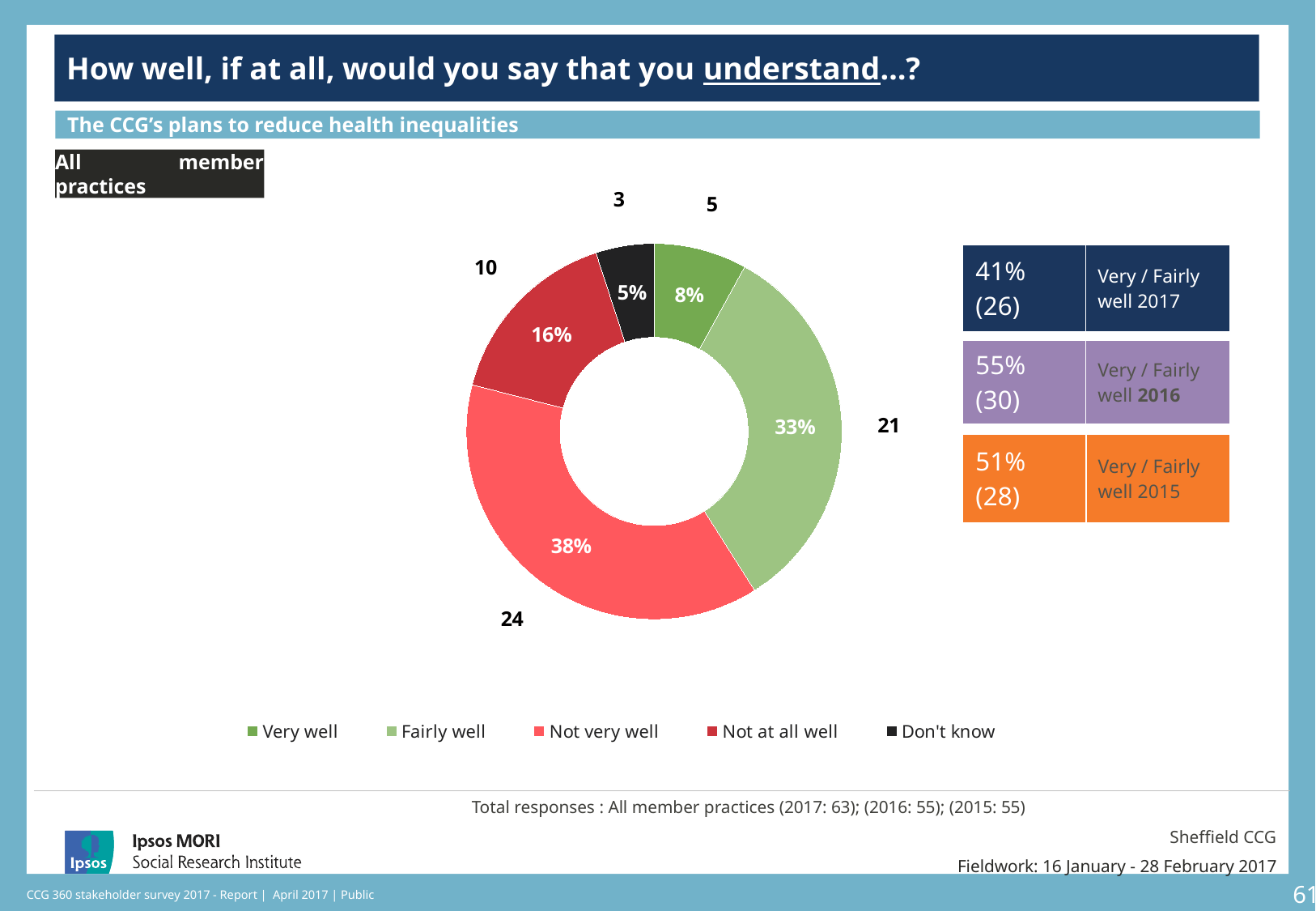
Which response category has the largest share of the donut chart? Not very well What percentage of respondents answered 'Very well'? 8% Which is larger, the share for 'Not at all well' or the share for 'Very well'? Not at all well What percentage of respondents said they understand the CCG's plans to reduce health inequalities 'Not very well'? 38% How many respondents answered 'Don't know'? 3 Which response category has the smallest share of the donut chart? Don't know What was the combined 'Very / Fairly well' percentage in 2016? 55% What type of chart is shown on the slide? Donut (pie) chart What percentage of respondents answered 'Fairly well'? 33% How many response categories does the legend list? 5 What is the difference in percentage points between 'Not very well' and 'Fairly well'? 5 How many respondents answered 'Not at all well'? 10